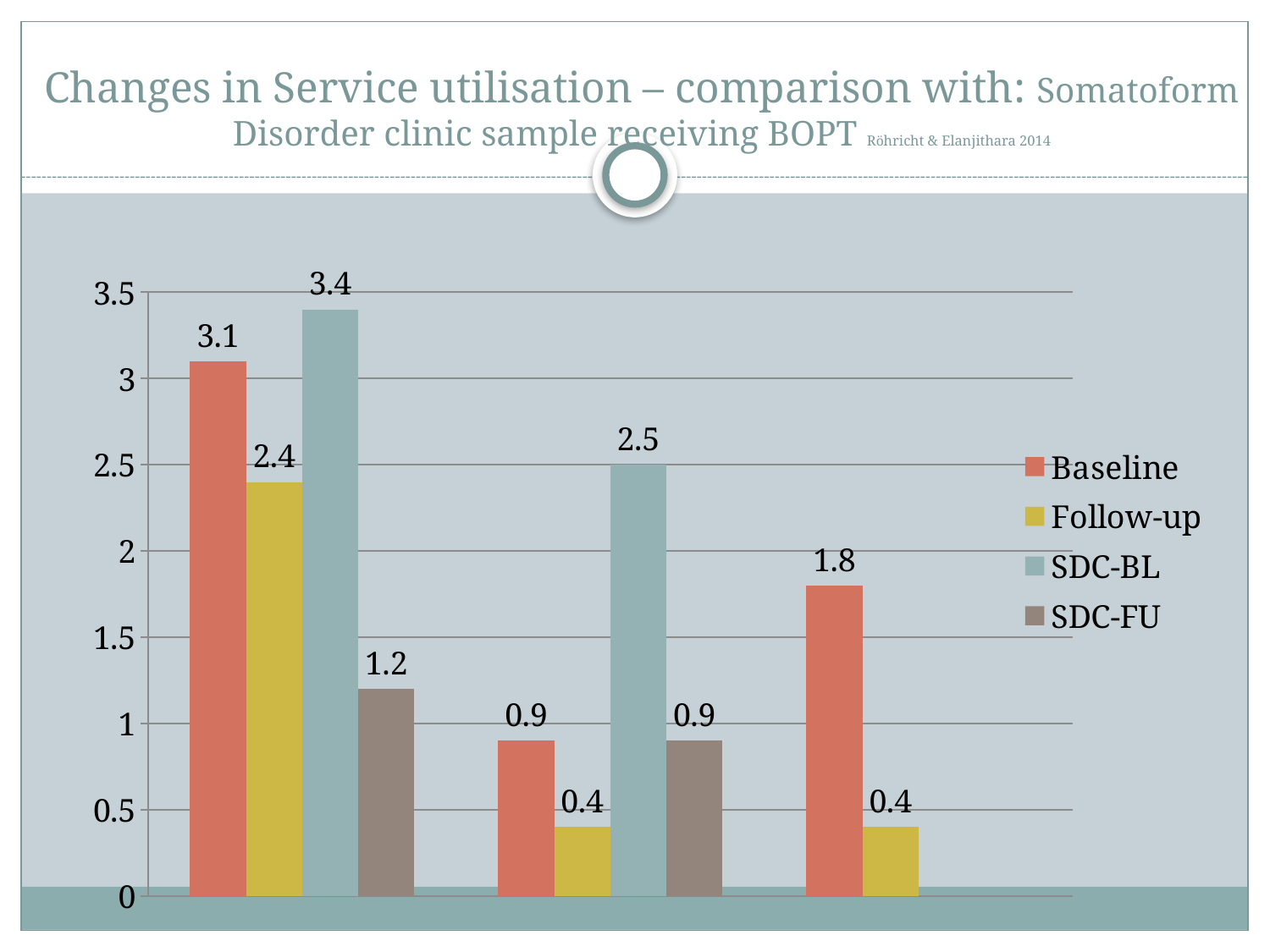
In the leftmost group of bars, what is the difference between the Baseline value and the Follow-up value? 0.7 Which series has the highest bar in the leftmost group of bars? SDC-BL Which series is shown in yellow in the legend? Follow-up What kind of chart is shown on the slide? bar chart What is the value of the Baseline bar in the rightmost group of bars? 1.8 What is the value of the SDC-FU bar in the middle group of bars? 0.9 In the middle group of bars, which is larger, the SDC-BL value or the Baseline value? SDC-BL What is the value of the Follow-up bar in the leftmost group of bars? 2.4 How many groups of bars are plotted along the x axis? 3 Which series has the lowest bar in the middle group of bars? Follow-up How many series does the legend list? 4 What is the value of the SDC-BL bar in the leftmost group of bars? 3.4